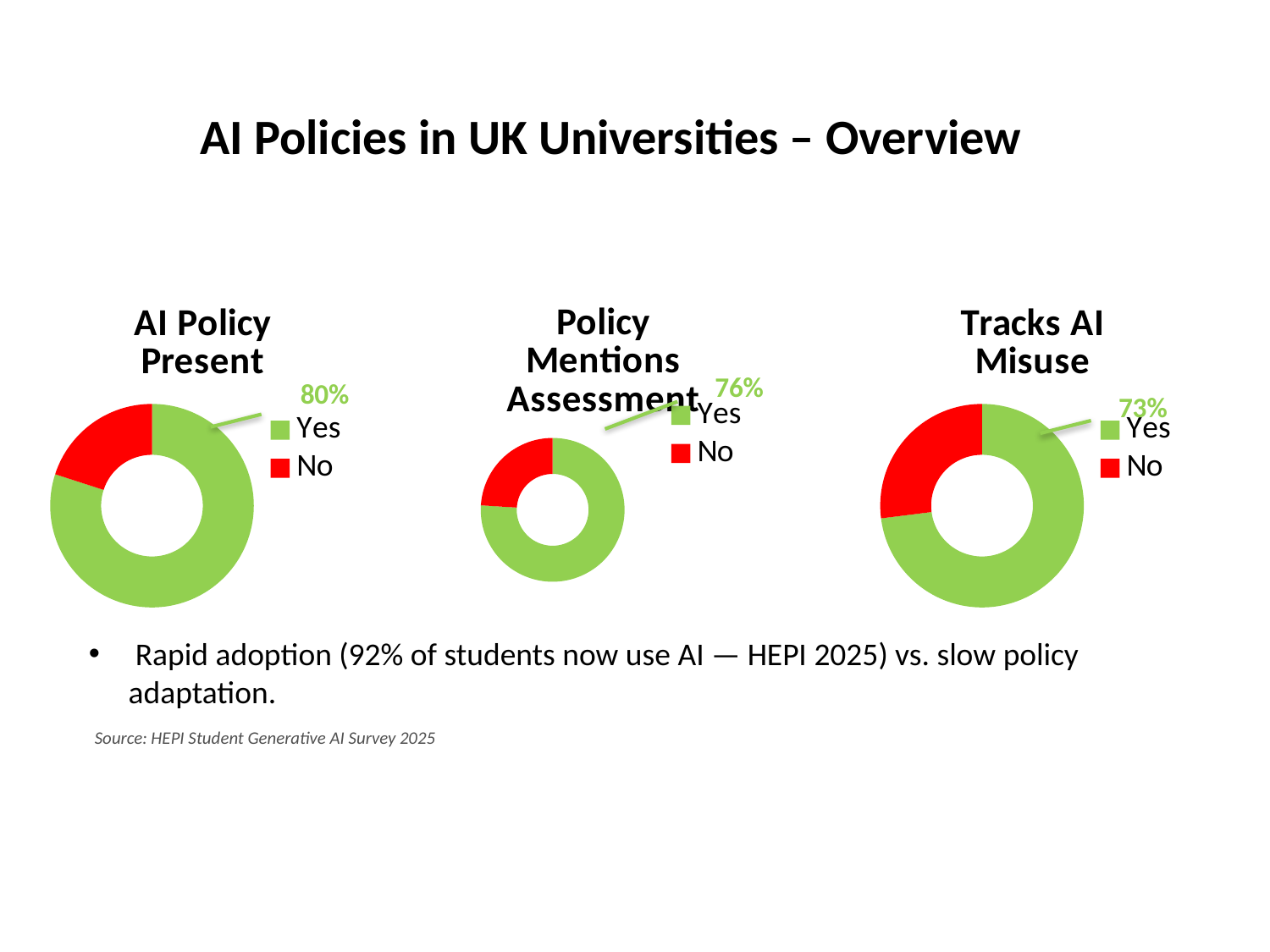
How many slices does the 'Tracks AI Misuse' chart have? 2 In the 'AI Policy Present' chart, what percentage is shown for Yes? 80% What is the difference between the Yes percentage in 'AI Policy Present' and the Yes percentage in 'Tracks AI Misuse'? 7% How many entries does the legend of the 'Policy Mentions Assessment' chart list? 2 In the 'Tracks AI Misuse' chart, which slice is larger, Yes or No? Yes Which of the three charts shows the highest Yes percentage? AI Policy Present What are the legend entries in the 'Policy Mentions Assessment' chart? Yes, No What kind of chart is the 'AI Policy Present' chart? Doughnut (pie) chart In the 'Tracks AI Misuse' chart, what percentage is shown for Yes? 73% Which of the three charts shows the lowest Yes percentage? Tracks AI Misuse In the 'Policy Mentions Assessment' chart, what percentage is shown for Yes? 76% In the 'AI Policy Present' chart, what colour represents the No slice? Red